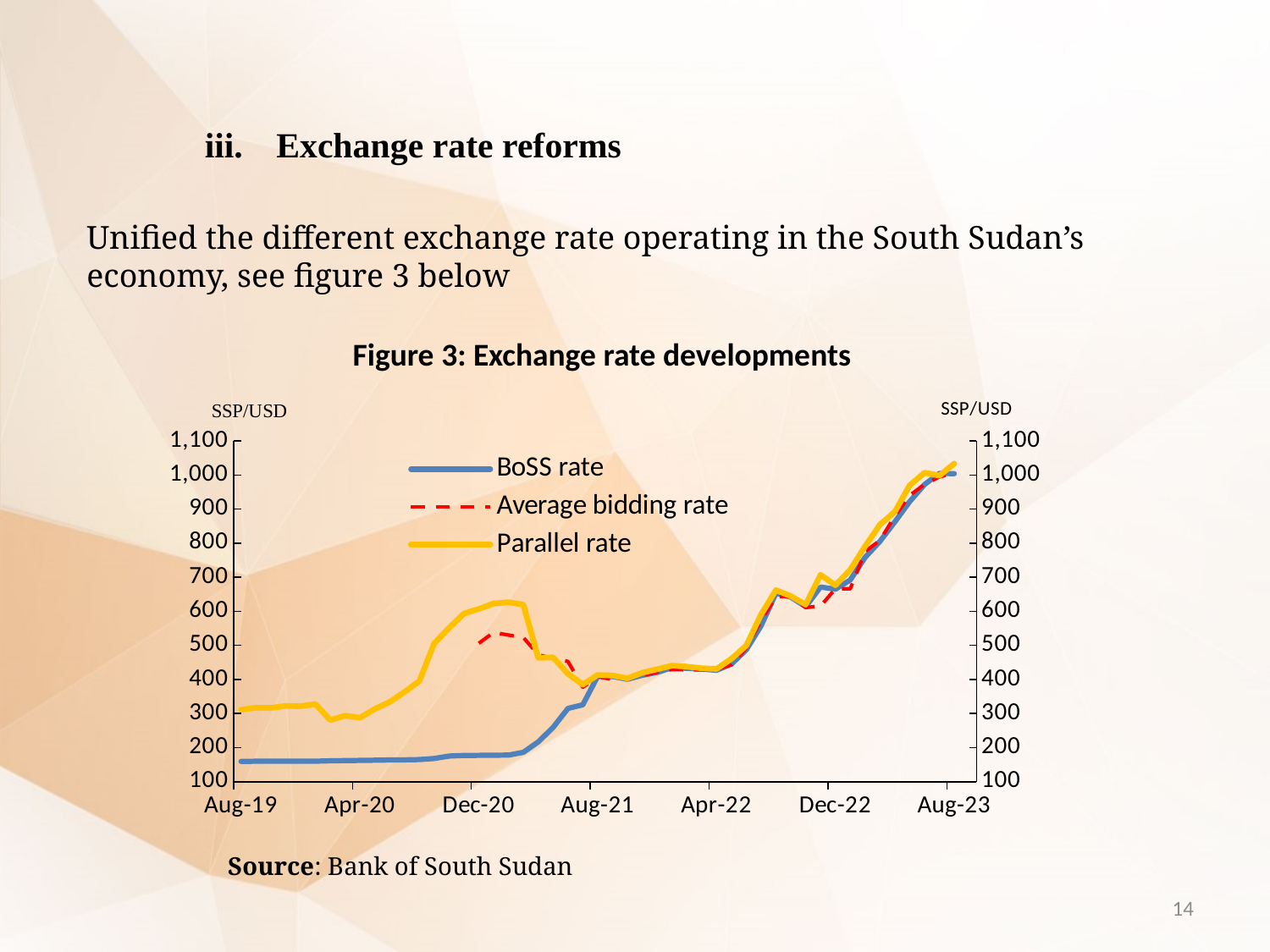
Is the BoSS rate at Dec-20 greater or less than 300? less Does the BoSS rate rise or fall overall from Aug-19 to Aug-23? rise Is the BoSS rate at Aug-19 greater or less than 200? less Is the Parallel rate at Dec-20 greater or less than 500? greater What unit is shown on the vertical axis of Figure 3? SSP/USD What kind of chart is Figure 3: Exchange rate developments? line chart At Dec-20, which is higher: the Parallel rate or the BoSS rate? Parallel rate How many date labels are shown on the x axis of Figure 3? 7 Which series has the highest value at Dec-20? Parallel rate How many series does the legend of Figure 3 list? 3 What is the title of the chart on the slide? Figure 3: Exchange rate developments